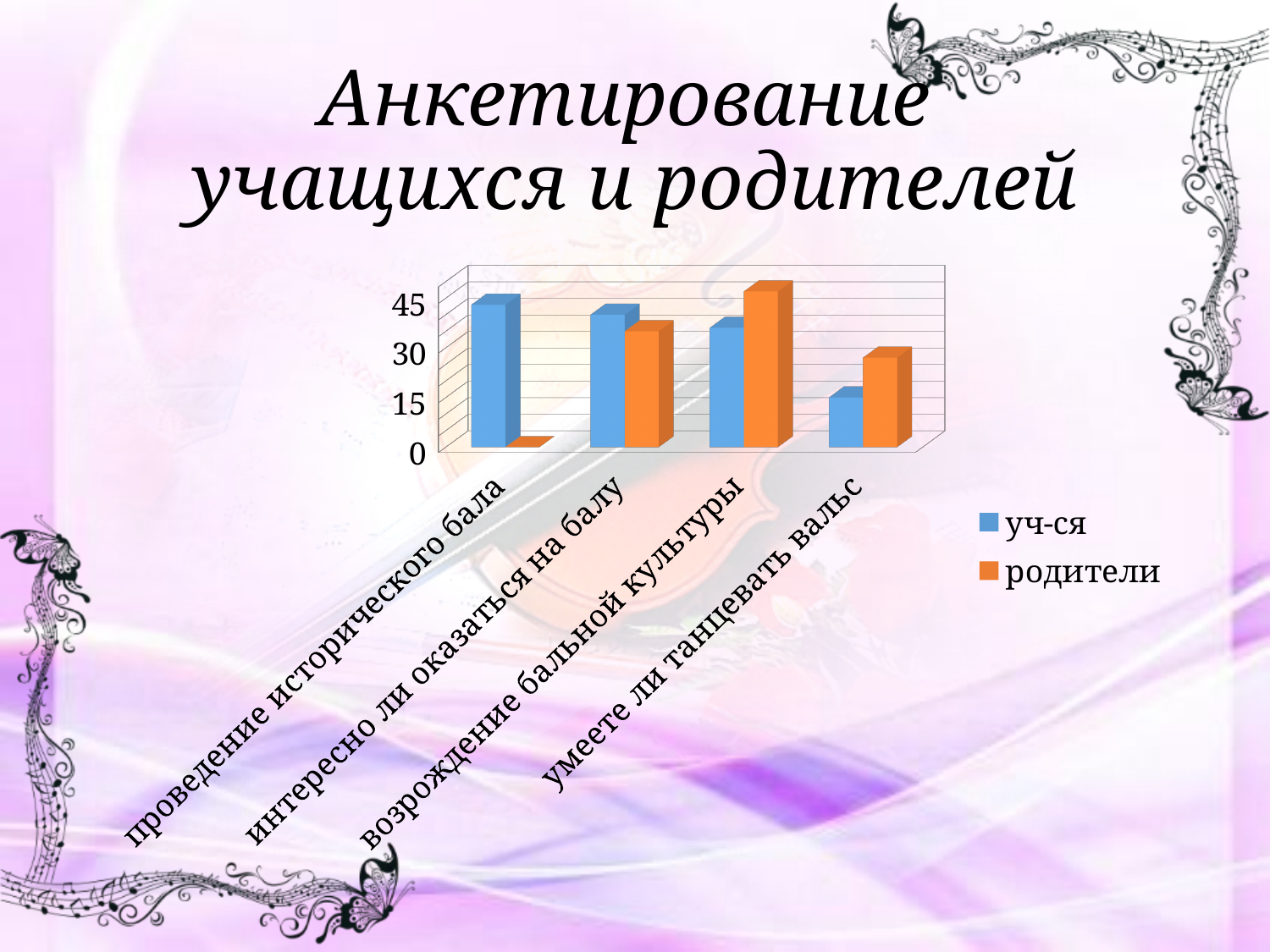
Is the value for родители in the category 'возрождение бальной культуры' greater or less than 30? greater For which category is the value for уч-ся the lowest? умеете ли танцевать вальс Is the value for уч-ся in the category 'умеете ли танцевать вальс' greater or less than 30? less How many categories are shown on the x axis of the chart? 4 For which category is the value for родители the lowest? проведение исторического бала Is the value for уч-ся in the category 'проведение исторического бала' greater or less than 30? greater In the category 'умеете ли танцевать вальс', which series has the larger value, уч-ся or родители? родители For which category is the value for родители the highest? возрождение бальной культуры Which series is shown in orange in the chart? родители What kind of chart is shown on the slide? bar chart How many series does the chart's legend list? 2